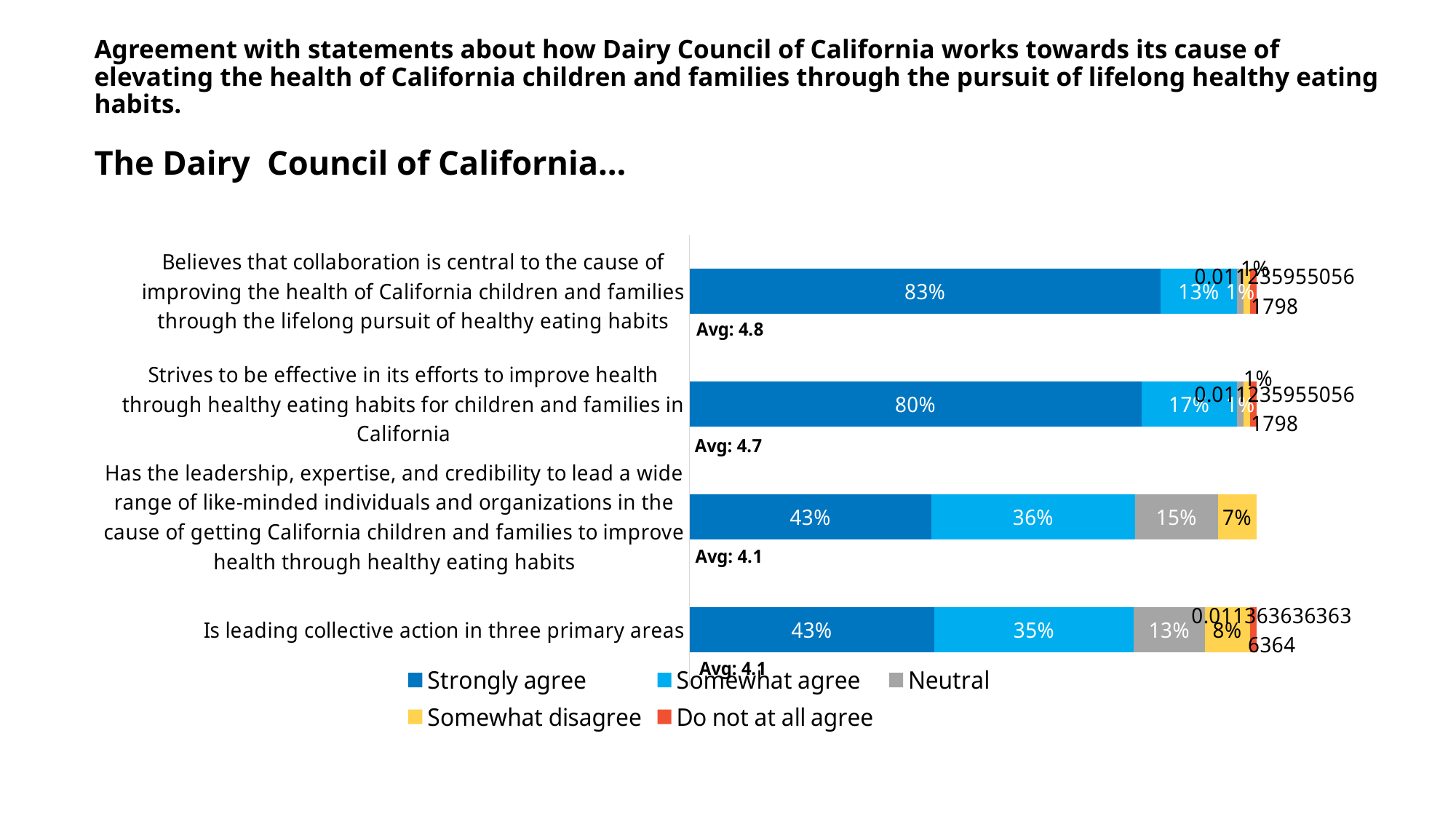
Which statement has the lowest Somewhat agree percentage? Believes that collaboration is central to the cause of improving the health of California children and families through the lifelong pursuit of healthy eating habits What percentage somewhat agree that the Dairy Council of California strives to be effective in its efforts to improve health? 17% How many series does the legend list? 5 Which is larger: the Somewhat agree percentage for the leadership, expertise, and credibility statement or for the leading collective action statement? Leadership, expertise, and credibility statement (36%) What average score is shown for the statement that the Dairy Council strives to be effective in its efforts to improve health? Avg: 4.7 What kind of chart is shown on the slide? Stacked bar chart Which statement has the highest Strongly agree percentage? Believes that collaboration is central to the cause of improving the health of California children and families through the lifelong pursuit of healthy eating habits What is the Neutral percentage for the statement that the Dairy Council has the leadership, expertise, and credibility to lead a wide range of like-minded individuals and organizations? 15% What percentage somewhat disagree that the Dairy Council of California is leading collective action in three primary areas? 8% What percentage strongly agree that the Dairy Council of California believes that collaboration is central to the cause? 83% What is the difference between the Strongly agree percentages for the collaboration statement and the strives to be effective statement? 3% How many statements (categories) are plotted in the chart? 4